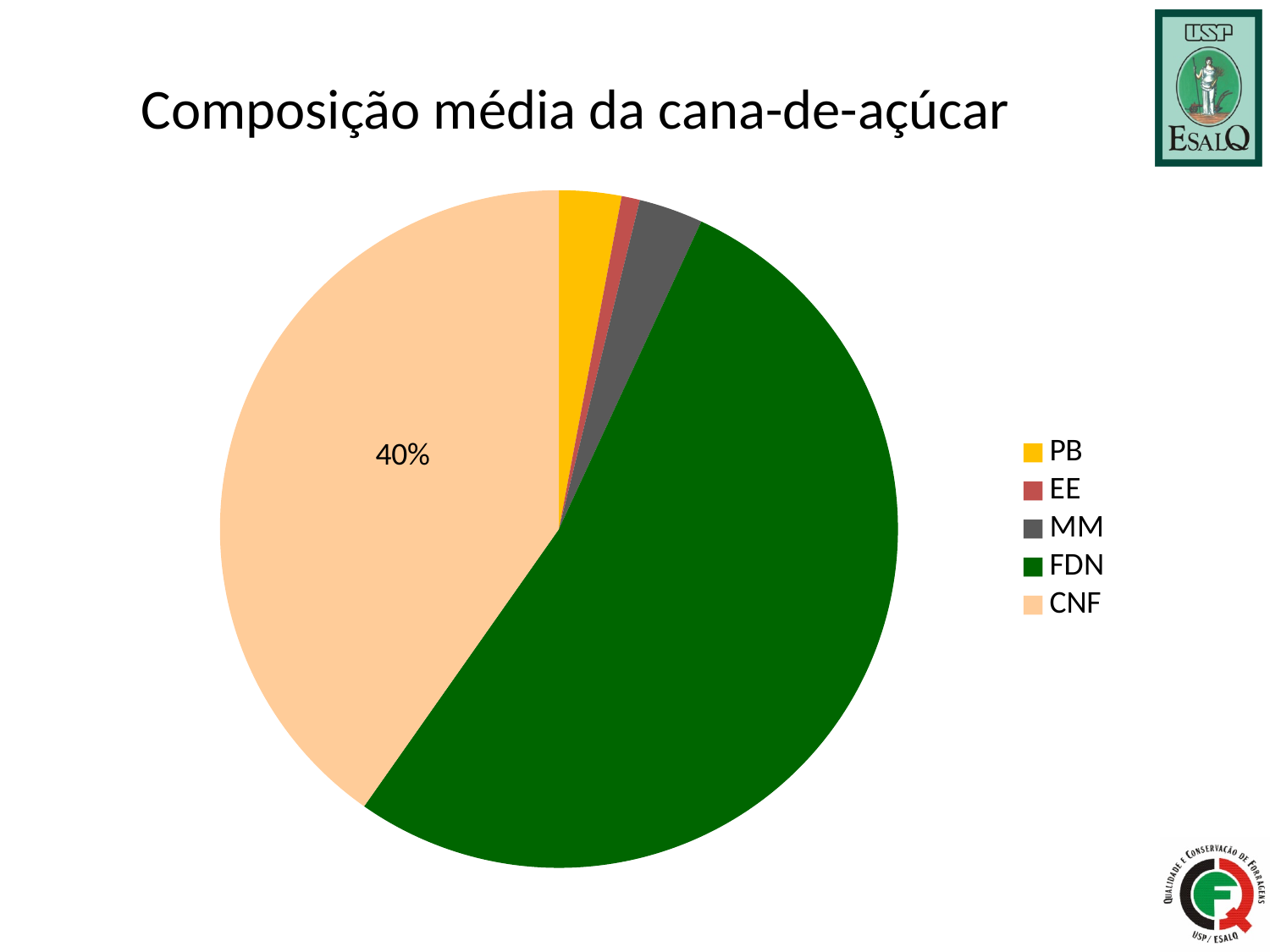
Which category has the smallest slice of the pie? EE What kind of chart is shown on the slide? pie chart How many entries does the legend list? 5 Which slice is larger, PB or EE? PB Which slice is larger, CNF or MM? CNF Which category has the largest slice of the pie? FDN How many slices does the pie chart have? 5 What is the title of the chart? Composição média da cana-de-açúcar Which slice is larger, FDN or CNF? FDN What share of the pie does CNF represent? 40% What colour is the FDN slice in the pie chart? dark green